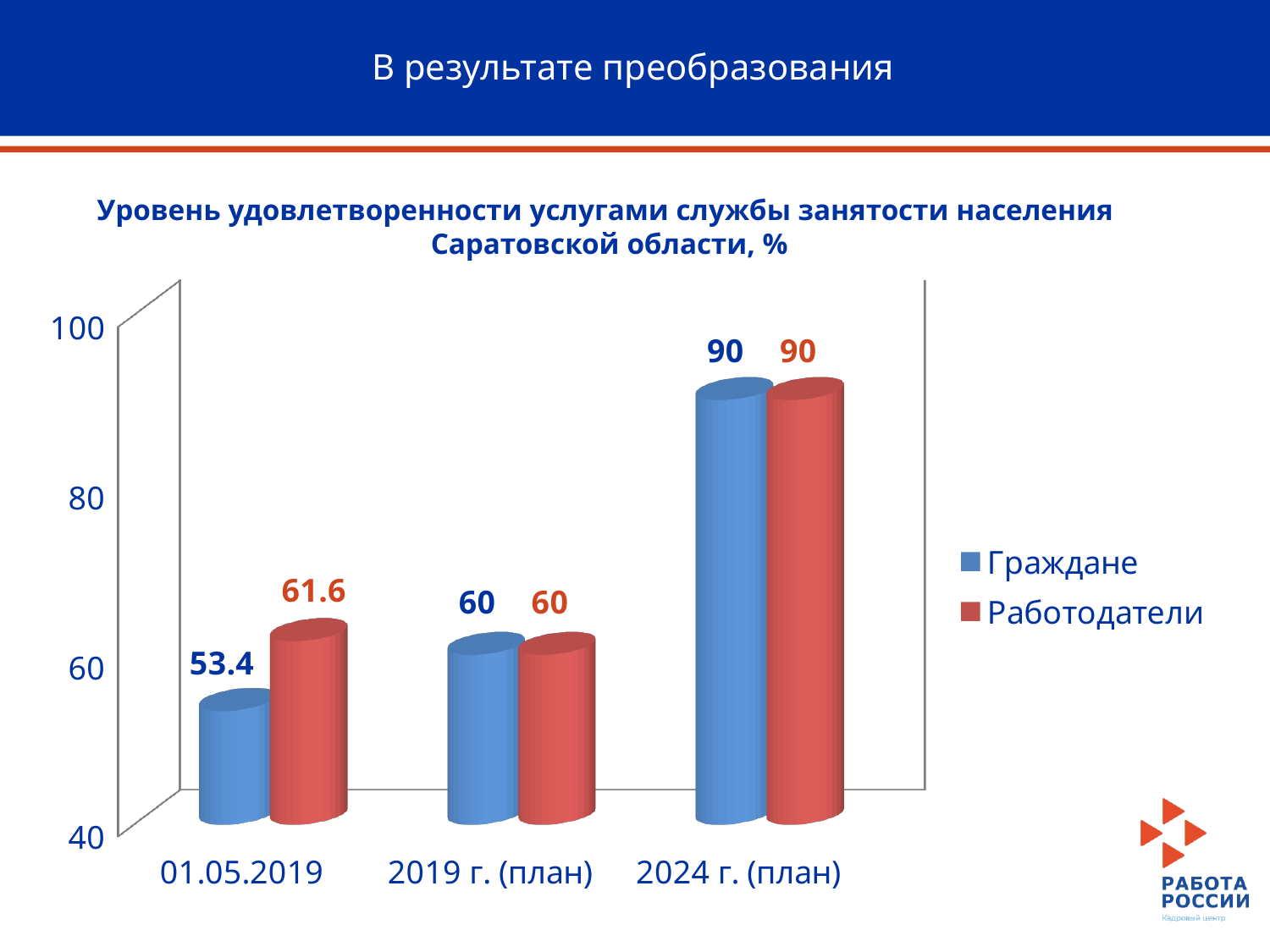
How many categories are shown on the x axis? 3 Do the values for Граждане rise or fall from 01.05.2019 to 2024 г. (план)? rise Which category has the highest value for Граждане? 2024 г. (план) What is the value for Работодатели at 01.05.2019? 61.6 What is the value for Работодатели in 2019 г. (план)? 60 What is the value for Граждане in 2024 г. (план)? 90 What is the difference between Работодатели and Граждане at 01.05.2019? 8.2 Which is larger at 01.05.2019: Граждане or Работодатели? Работодатели How many series does the legend list? 2 What is the value for Граждане at 01.05.2019? 53.4 What kind of chart is shown on the slide? bar chart Which category has the lowest value for Работодатели? 2019 г. (план)